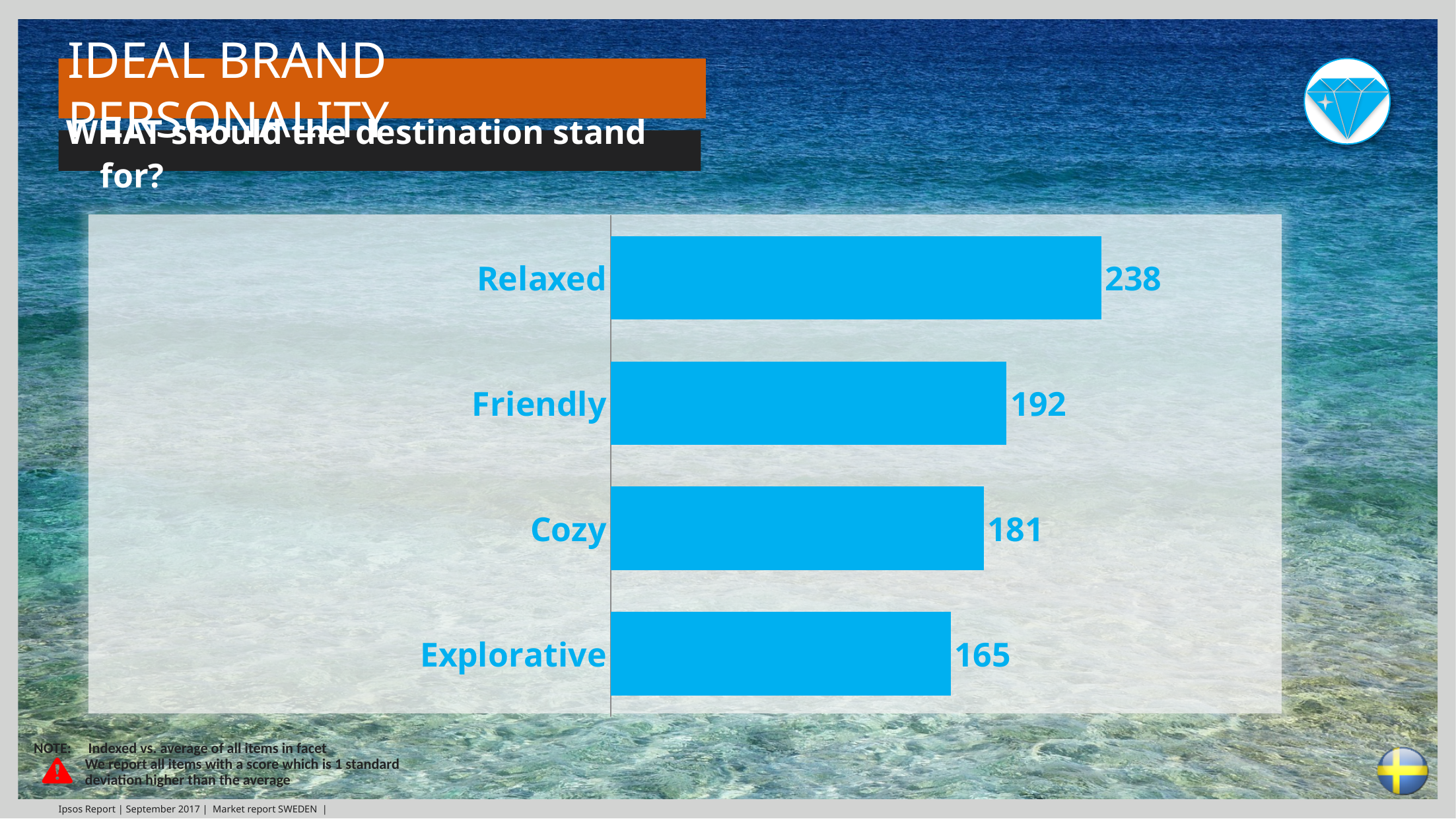
What colour are the bars in the chart? Blue What is the value for Cozy? 181 What is the value for Explorative? 165 What is the difference between the values for Cozy and Explorative? 16 Which category has the lowest value? Explorative What is the difference between the values for Relaxed and Friendly? 46 How many categories are shown in the chart? 4 What is the value for Friendly? 192 What kind of chart is shown on the slide? Bar chart Which is larger, the value for Friendly or the value for Cozy? Friendly What is the value for Relaxed? 238 Which category has the highest value? Relaxed